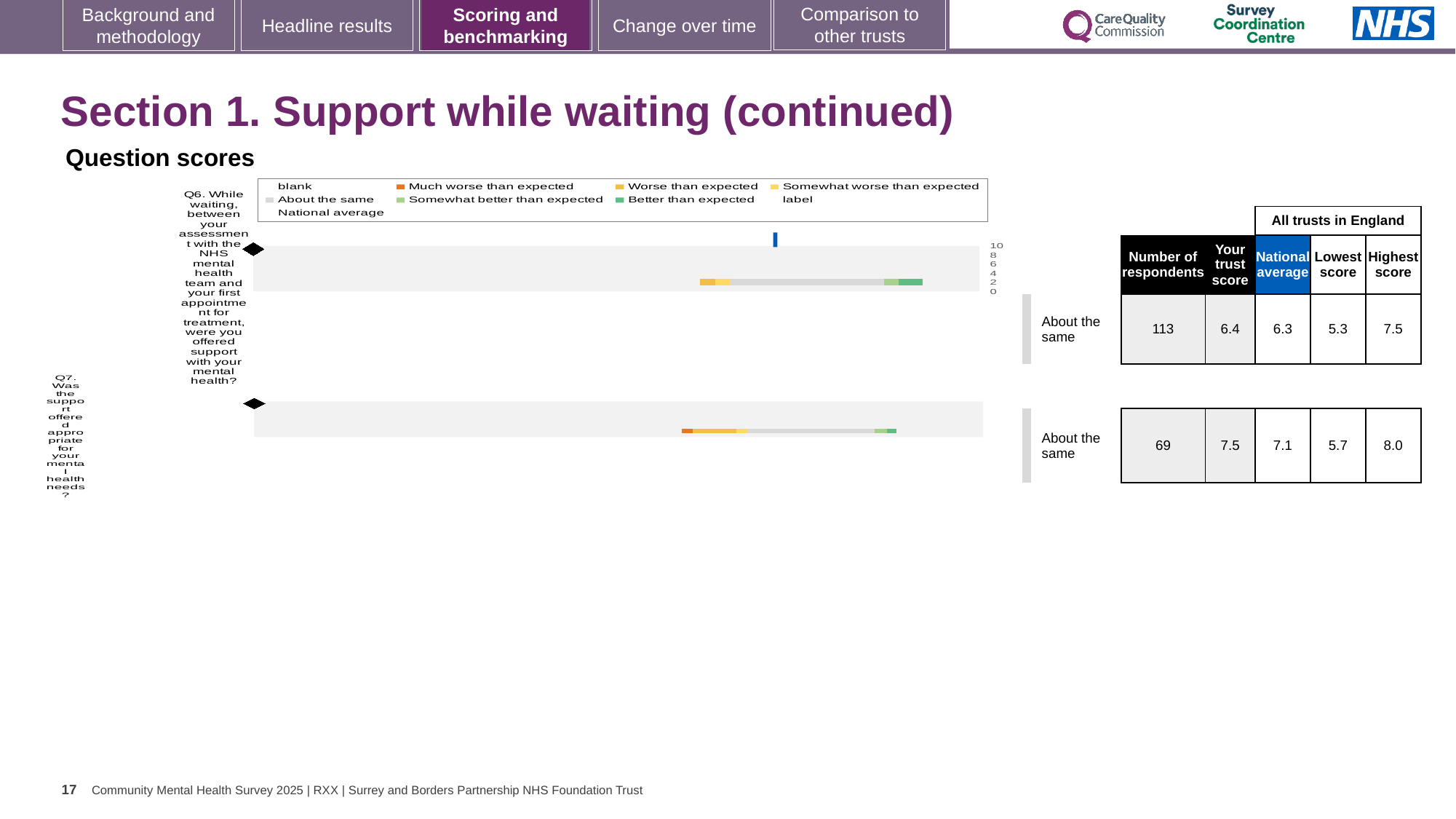
What is the national average score for Q7 (was the support offered appropriate)? 7.1 What kind of chart is used to show the question scores for Q6 and Q7? bar chart What is the difference between the trust score and the national average for Q7? 0.4 What is the lowest score among all trusts in England for Q6? 5.3 What is the highest score among all trusts in England for Q7? 8.0 What is the number of respondents for Q6 in the table next to the chart? 113 What colour is used in the legend for 'Much worse than expected'? Orange Which question has the higher trust score, Q6 or Q7? Q7 What is the trust score for Q6 (support with mental health while waiting)? 6.4 How many questions (bars) are plotted in the question scores chart? 2 What benchmark category is shown for Q6 next to the chart? About the same What is the difference between the highest and lowest scores for Q6? 2.2